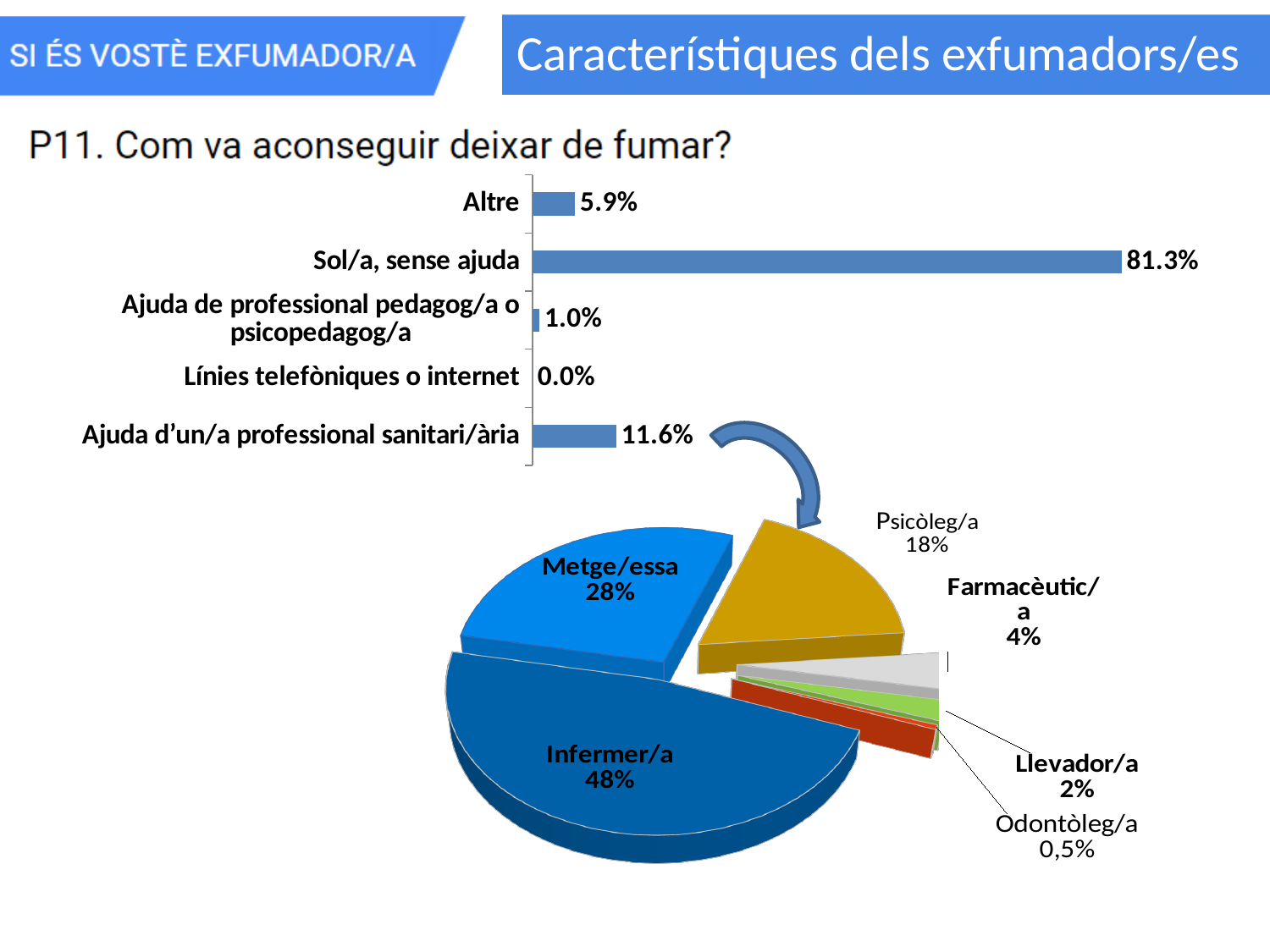
How many categories does the bar chart show? 5 In the pie chart, what share does 'Odontòleg/a' have? 0,5% In the bar chart, which is larger: 'Altre' or 'Ajuda de professional pedagog/a o psicopedagog/a'? Altre In the bar chart, what is the value for 'Ajuda d'un/a professional sanitari/ària'? 11.6% In the bar chart, which category has the lowest value? Línies telefòniques o internet In the bar chart, what is the difference between 'Sol/a, sense ajuda' and 'Ajuda d'un/a professional sanitari/ària'? 69.7% In the pie chart, what share does 'Infermer/a' have? 48% In the bar chart, which category has the highest value? Sol/a, sense ajuda In the bar chart, what is the value for 'Sol/a, sense ajuda'? 81.3% What kind of chart is the chart at the top of the slide? Bar chart In the pie chart, which slice is the largest? Infermer/a How many slices does the pie chart have? 6